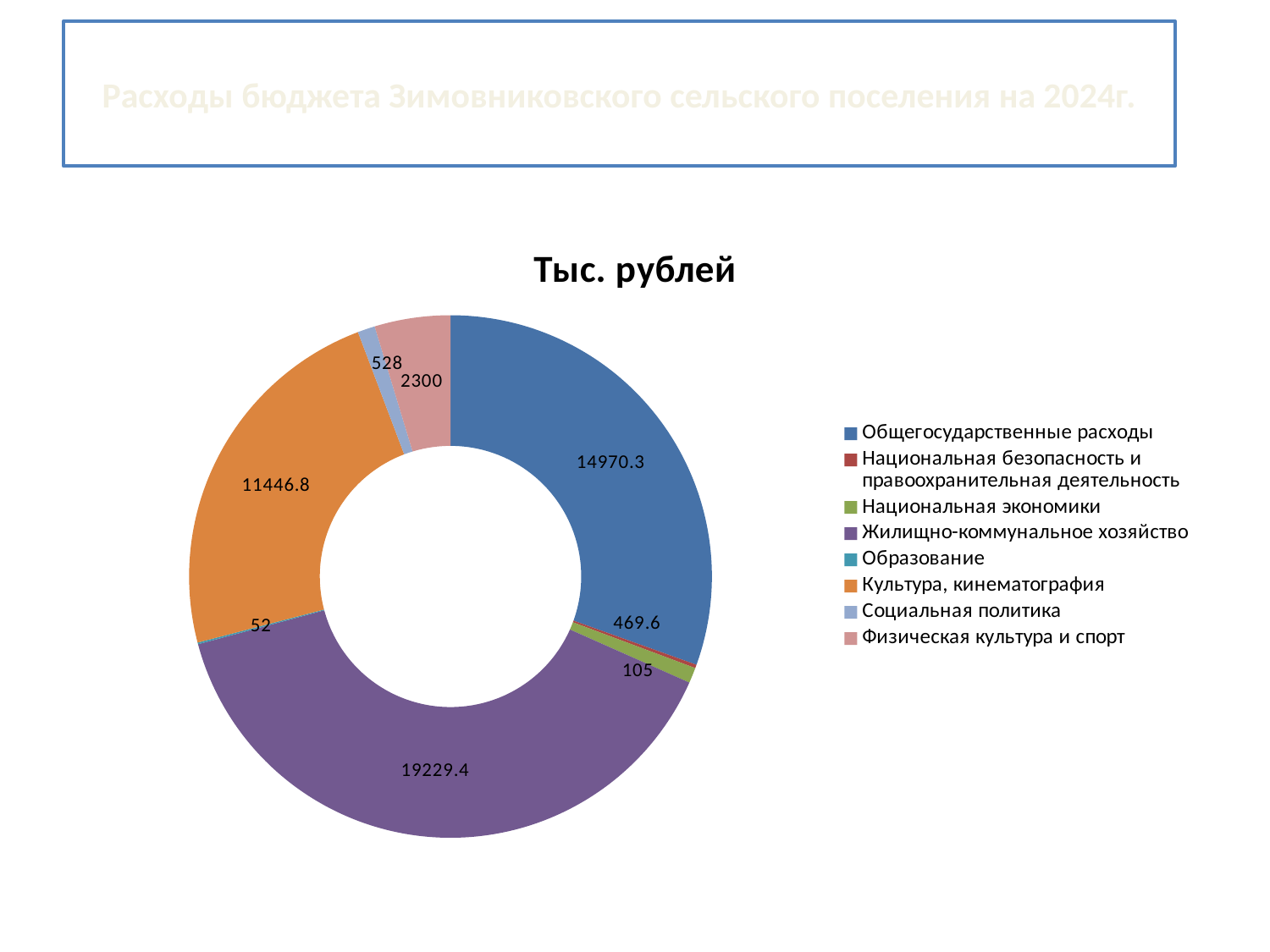
What kind of chart is shown on the slide? doughnut chart What is the value for Жилищно-коммунальное хозяйство? 19229.4 What is the value for Общегосударственные расходы? 14970.3 How many categories does the chart's legend list? 8 What is the difference between the values for Жилищно-коммунальное хозяйство and Общегосударственные расходы? 4259.1 What is the value for Культура, кинематография? 11446.8 What is the title of the chart? Тыс. рублей Which is larger, the value for Общегосударственные расходы or the value for Культура, кинематография? Общегосударственные расходы What is the value for Социальная политика? 528 Which category has the smallest value? Образование Which category has the largest value? Жилищно-коммунальное хозяйство What is the value for Физическая культура и спорт? 2300